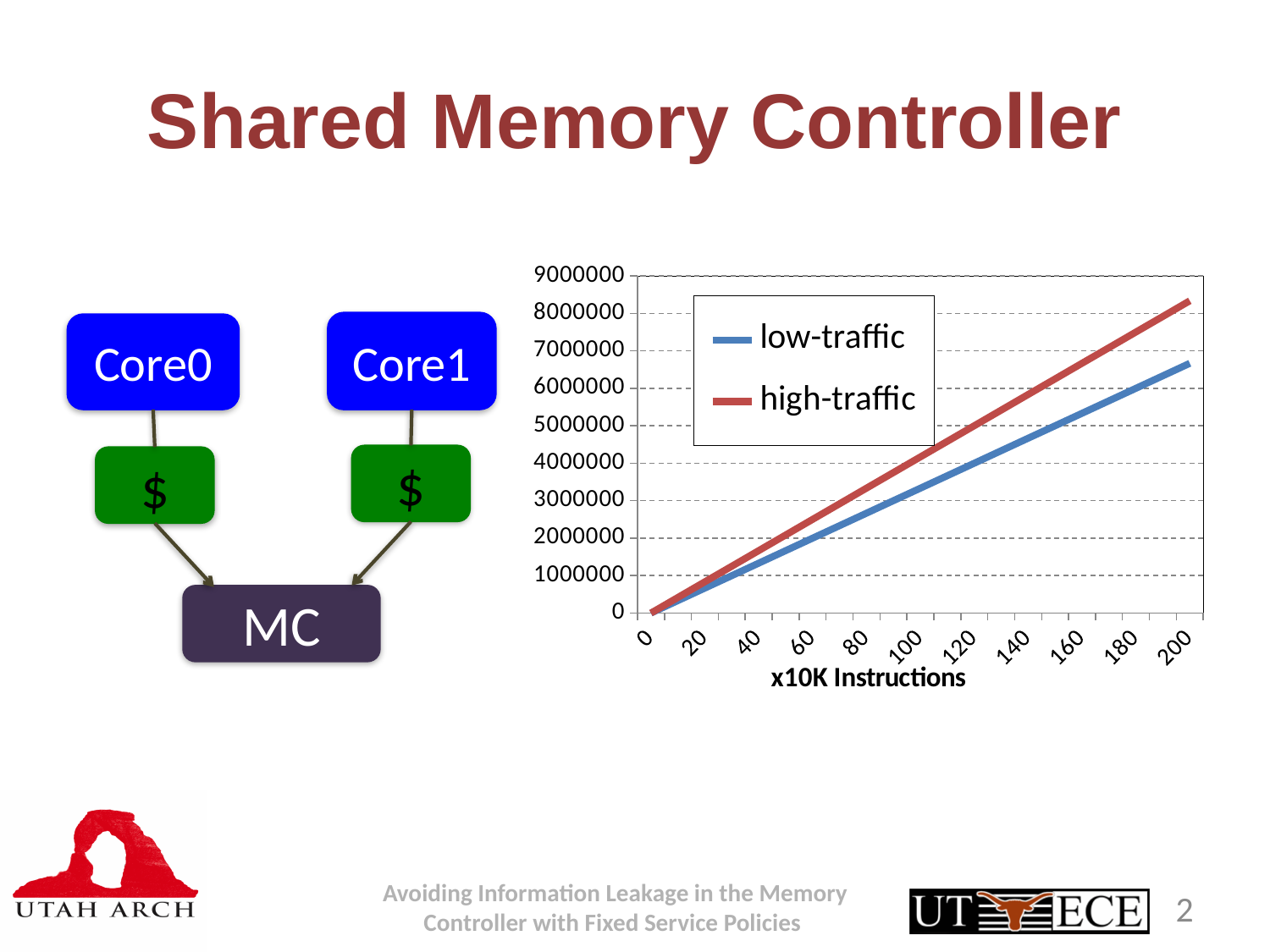
Is the value of the low-traffic series at x = 200 greater or less than 7000000? less Is the value of the low-traffic series at x = 100 greater or less than 4000000? less What kind of chart is shown on the slide? line chart What are the two series named in the chart's legend? low-traffic and high-traffic Do the values of the high-traffic series rise or fall as the x axis increases? rise At x = 200, which series has the larger value, low-traffic or high-traffic? high-traffic How many tick labels are shown on the chart's x axis? 11 Is the value of the low-traffic series at x = 200 greater or less than 6000000? greater How many series does the chart's legend list? 2 What is the x-axis title of the chart? x10K Instructions Do the values of the low-traffic series rise or fall as the x axis increases? rise